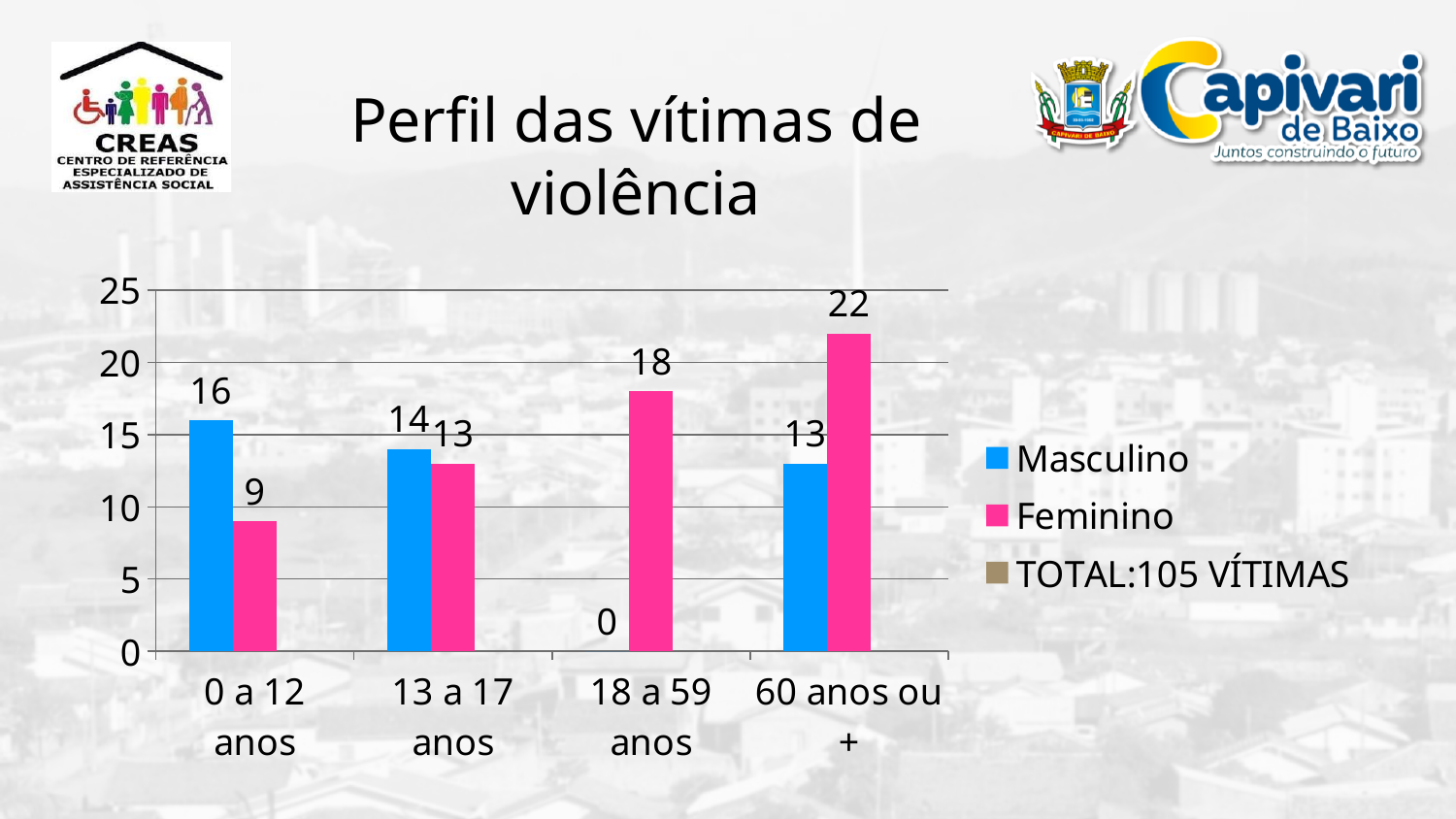
Which age category has the highest Feminino value? 60 anos ou + What is the Feminino value for the 13 a 17 anos category? 13 Which age category has the lowest Masculino value? 18 a 59 anos What is the title of the slide containing the chart? Perfil das vítimas de violência What is the difference between the Feminino and Masculino values for the 60 anos ou + category? 9 How many entries does the legend list? 3 In the 0 a 12 anos category, which is larger, Masculino or Feminino? Masculino What kind of chart is shown on the slide? Bar chart What is the Masculino value for the 18 a 59 anos category? 0 How many age categories are shown on the x axis? 4 What is the Masculino value for the 0 a 12 anos category? 16 What is the Feminino value for the 60 anos ou + category? 22